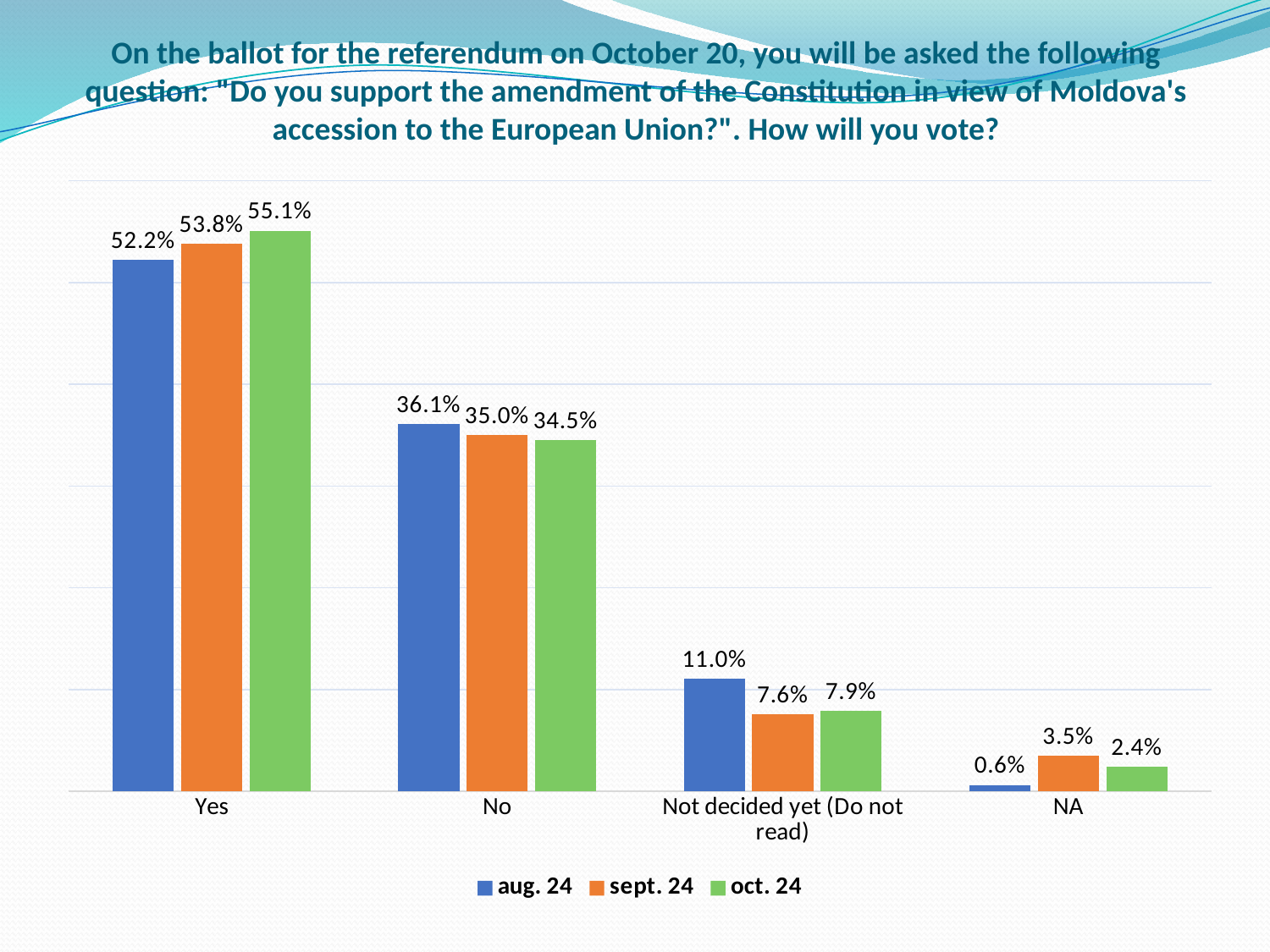
What is the value for "No" in the aug. 24 series? 36.1% What is the value for "Not decided yet (Do not read)" in the sept. 24 series? 7.6% Which series is shown in orange in the legend? sept. 24 How many categories are shown on the x axis? 4 What is the value for "NA" in the aug. 24 series? 0.6% What kind of chart is shown on the slide? Bar chart What is the value for "Yes" in the oct. 24 series? 55.1% What is the difference between the oct. 24 and aug. 24 values for "Yes"? 2.9% Which is larger: the aug. 24 value for "Not decided yet (Do not read)" or the oct. 24 value for the same category? aug. 24 Which category has the highest value in the sept. 24 series? Yes Which category has the lowest value in the oct. 24 series? NA How many series does the legend list? 3